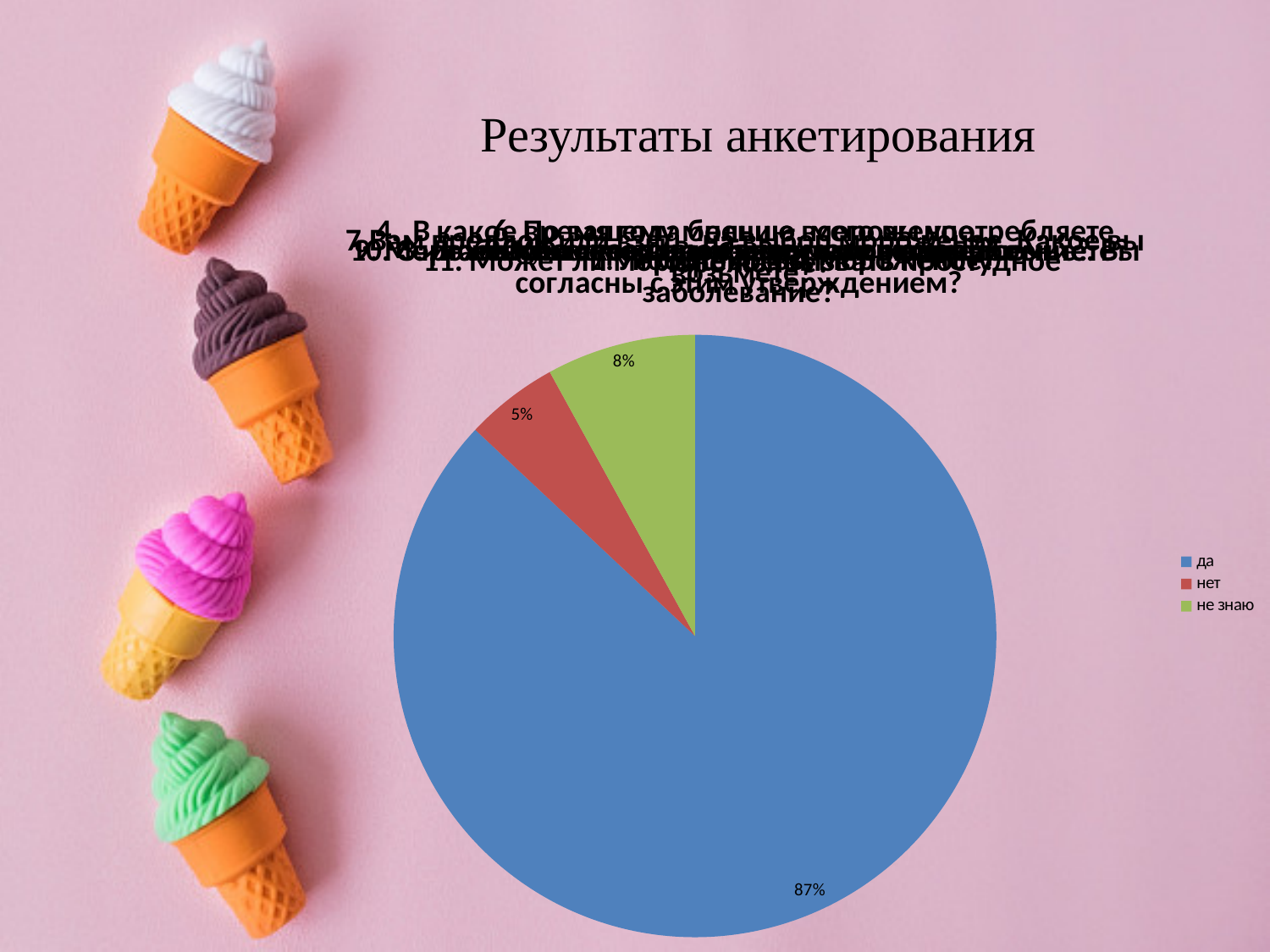
Which category has the smallest slice of the pie? нет What colour is the "да" slice of the pie? blue What kind of chart is shown on the slide? pie chart How many categories does the pie chart have? 3 What share of the pie does the "не знаю" slice represent? 8% How many entries does the legend list? 3 What is the difference in percentage points between the "не знаю" slice and the "нет" slice? 3% What share of the pie does the "да" slice represent? 87% Which category has the largest slice of the pie? да What share of the pie does the "нет" slice represent? 5% What is the difference in percentage points between the "да" slice and the "не знаю" slice? 79% Which slice is larger, "нет" or "не знаю"? не знаю